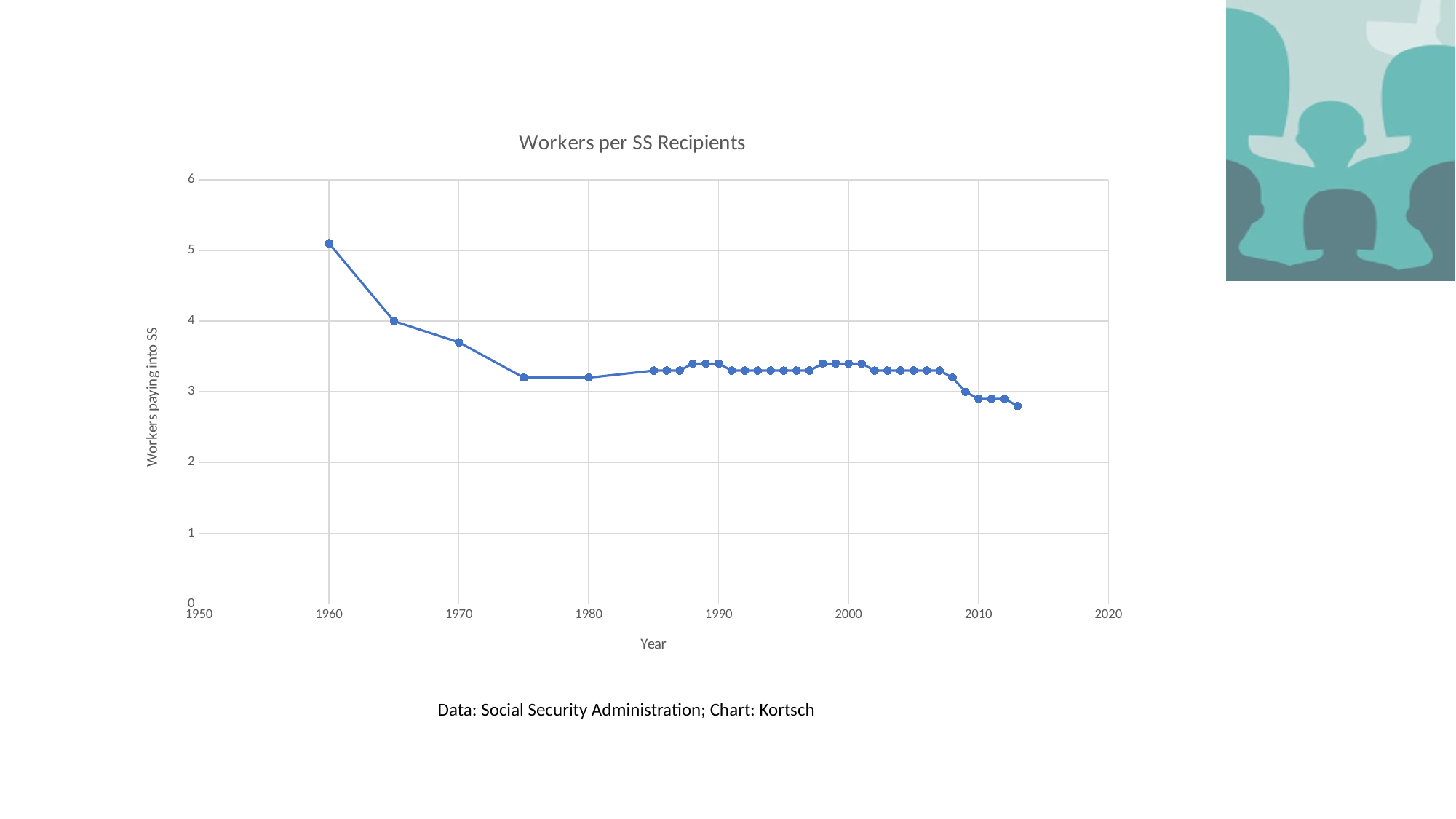
What kind of chart is shown on the slide? line chart Is the value for 1975 greater or less than 3? greater Is the value for 1960 greater or less than 5? greater Is the value for 1970 greater or less than 4? less In which year is the number of workers per SS recipient highest? 1960 What is the label on the vertical axis of the chart? Workers paying into SS In which year is the number of workers per SS recipient lowest? 2013 Overall, do the values rise or fall from 1960 to 2013? fall Which year has the larger value, 1960 or 1980? 1960 What is the title of the chart? Workers per SS Recipients